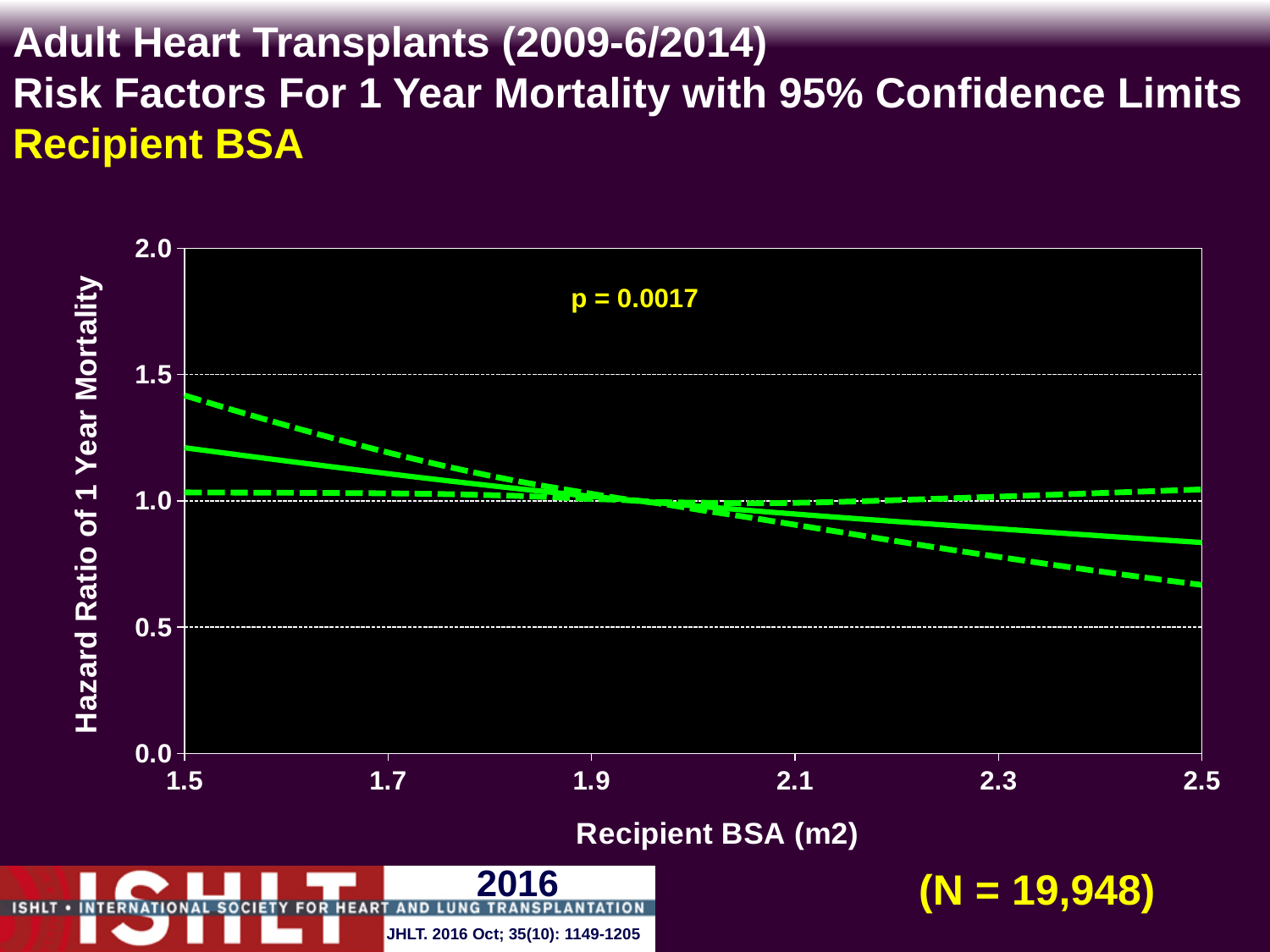
Is the solid hazard ratio line higher at a Recipient BSA of 1.5 or at 2.5? 1.5 Does the solid hazard ratio line rise or fall as Recipient BSA increases from 1.5 to 2.5? fall Is the solid hazard ratio line at a Recipient BSA of 1.5 greater or less than 1.0? greater Is the lower dashed confidence limit at a Recipient BSA of 2.5 greater or less than 0.5? greater Is the solid hazard ratio line at a Recipient BSA of 1.5 greater or less than 1.5? less How many tick labels are shown on the x axis (Recipient BSA)? 6 How many lines are plotted on the chart? 3 What p-value is printed on the chart? p = 0.0017 What kind of chart is shown on the slide? line chart What sample size (N) is shown on the slide? N = 19,948